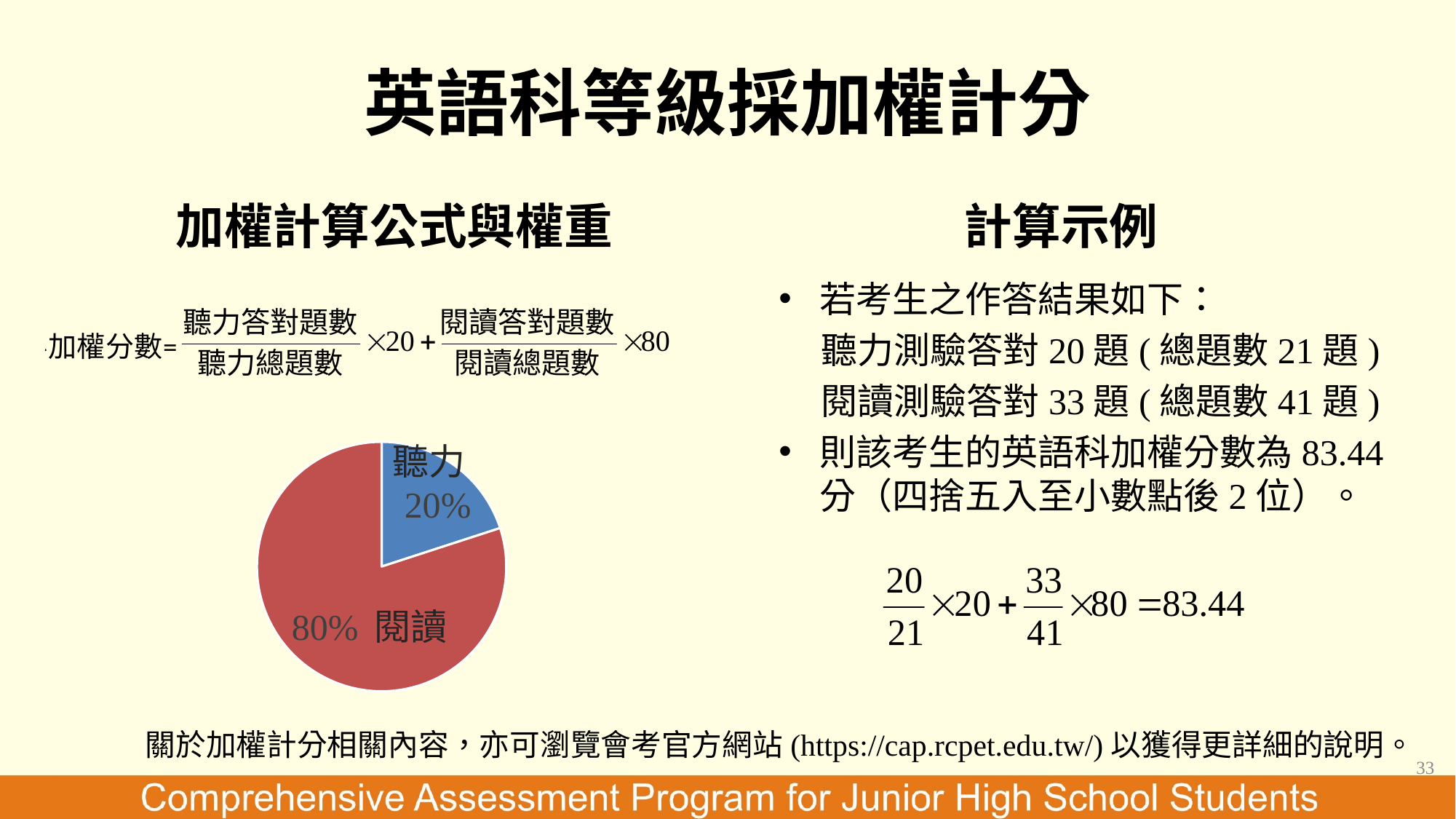
What colour is the 聽力 slice of the pie chart? blue What colour is the 閱讀 slice of the pie chart? red Which is larger in the pie chart, 聽力 or 閱讀? 閱讀 What is the difference in percentage points between the 閱讀 slice and the 聽力 slice? 60 Which slice of the pie chart is the smallest? 聽力 What is the total of the two slices shown in the pie chart? 100% What share of the pie chart does 聽力 represent? 20% What share of the pie chart does 閱讀 represent? 80% Which slice of the pie chart is the largest? 閱讀 How many slices does the pie chart have? 2 What kind of chart is shown on the slide? pie chart